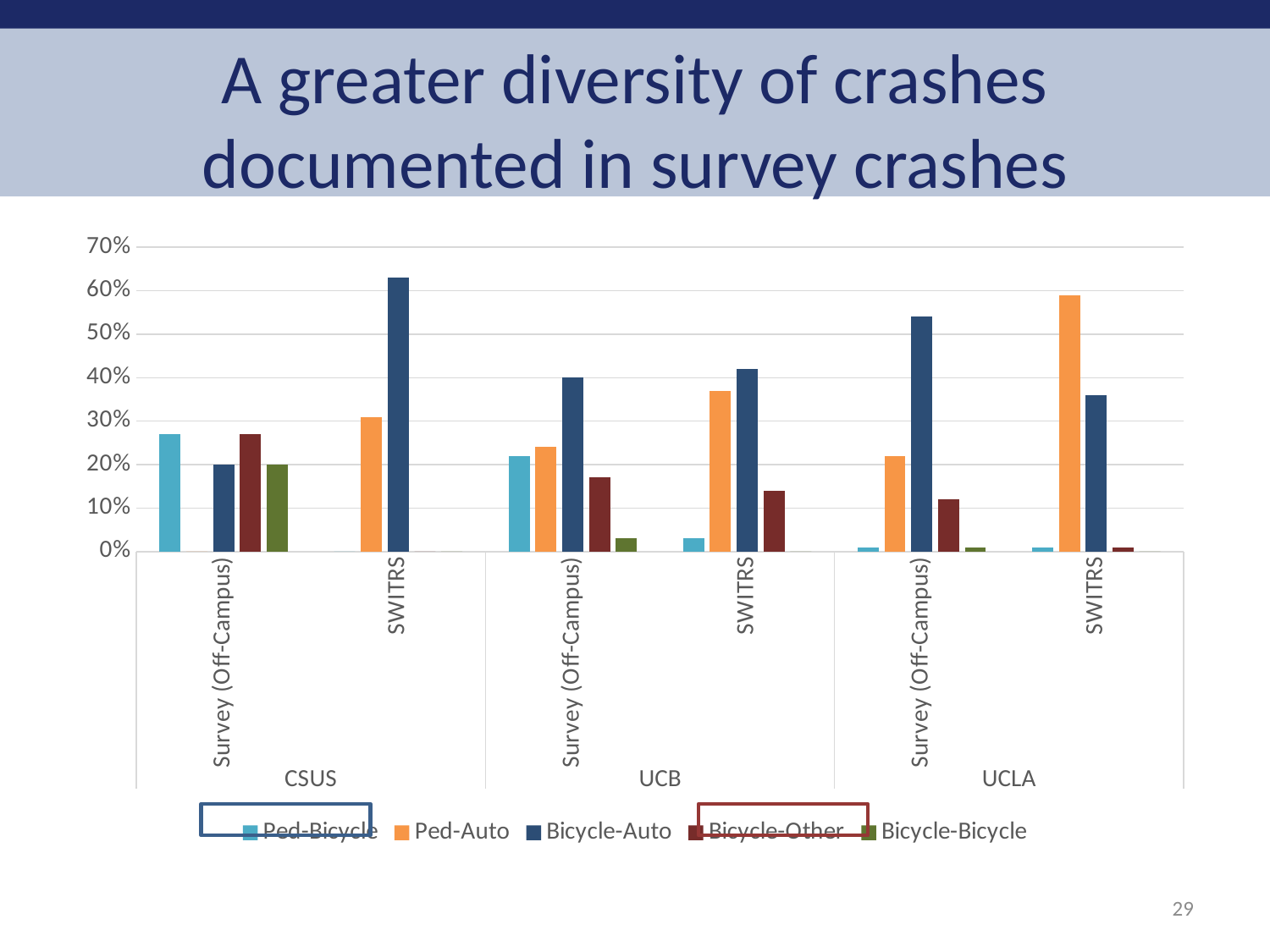
How many campuses are shown along the x axis? 3 Which is larger, the Bicycle-Bicycle value for CSUS Survey (Off-Campus) or for UCB Survey (Off-Campus)? CSUS Survey (Off-Campus) What colour represents the Bicycle-Auto series in the legend? Dark blue Which crash type has the highest value for CSUS SWITRS? Bicycle-Auto Is the Bicycle-Auto value for CSUS SWITRS greater or less than 60%? greater Which is larger, the Bicycle-Auto value for UCLA Survey (Off-Campus) or for UCLA SWITRS? UCLA Survey (Off-Campus) How many series does the legend list? 5 Which crash type has the highest value for UCLA SWITRS? Ped-Auto Is the Bicycle-Auto value for UCB Survey (Off-Campus) greater or less than 30%? greater What kind of chart is shown on the slide? Bar chart Is the Ped-Auto value for UCLA SWITRS greater or less than 50%? greater